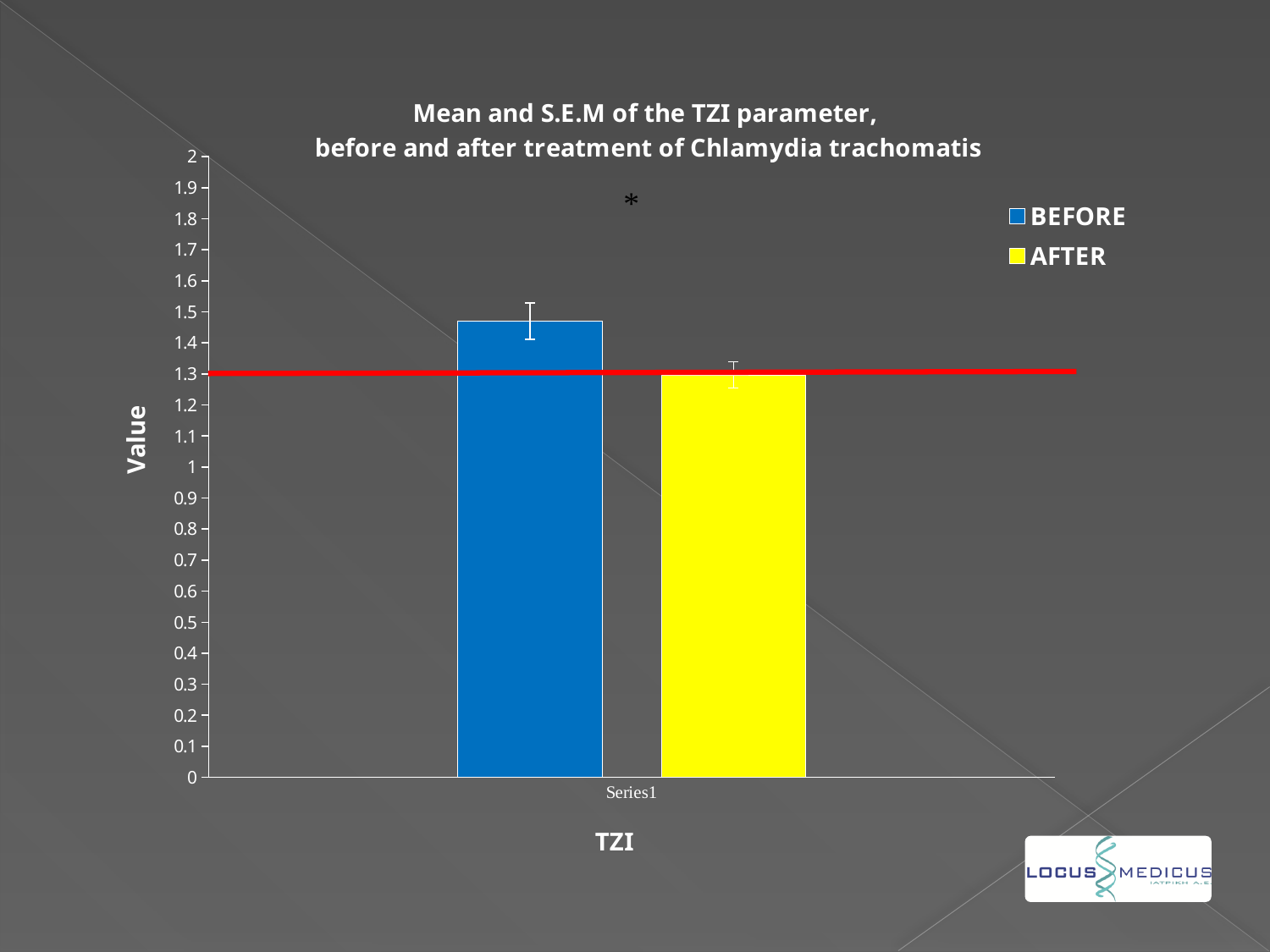
Is the value for AFTER greater or less than 1.4? less What colour is the BEFORE series in the chart? blue How many series does the legend list? 2 Is the value for BEFORE greater or less than 1.4? greater Is the value for AFTER greater or less than 1.2? greater What kind of chart is shown on the slide? bar chart Which series has the taller bar, BEFORE or AFTER? BEFORE Which series has the shorter bar, BEFORE or AFTER? AFTER What is the label of the y axis? Value Is the value for BEFORE larger or smaller than the value for AFTER? larger How many categories are shown on the x axis? 1